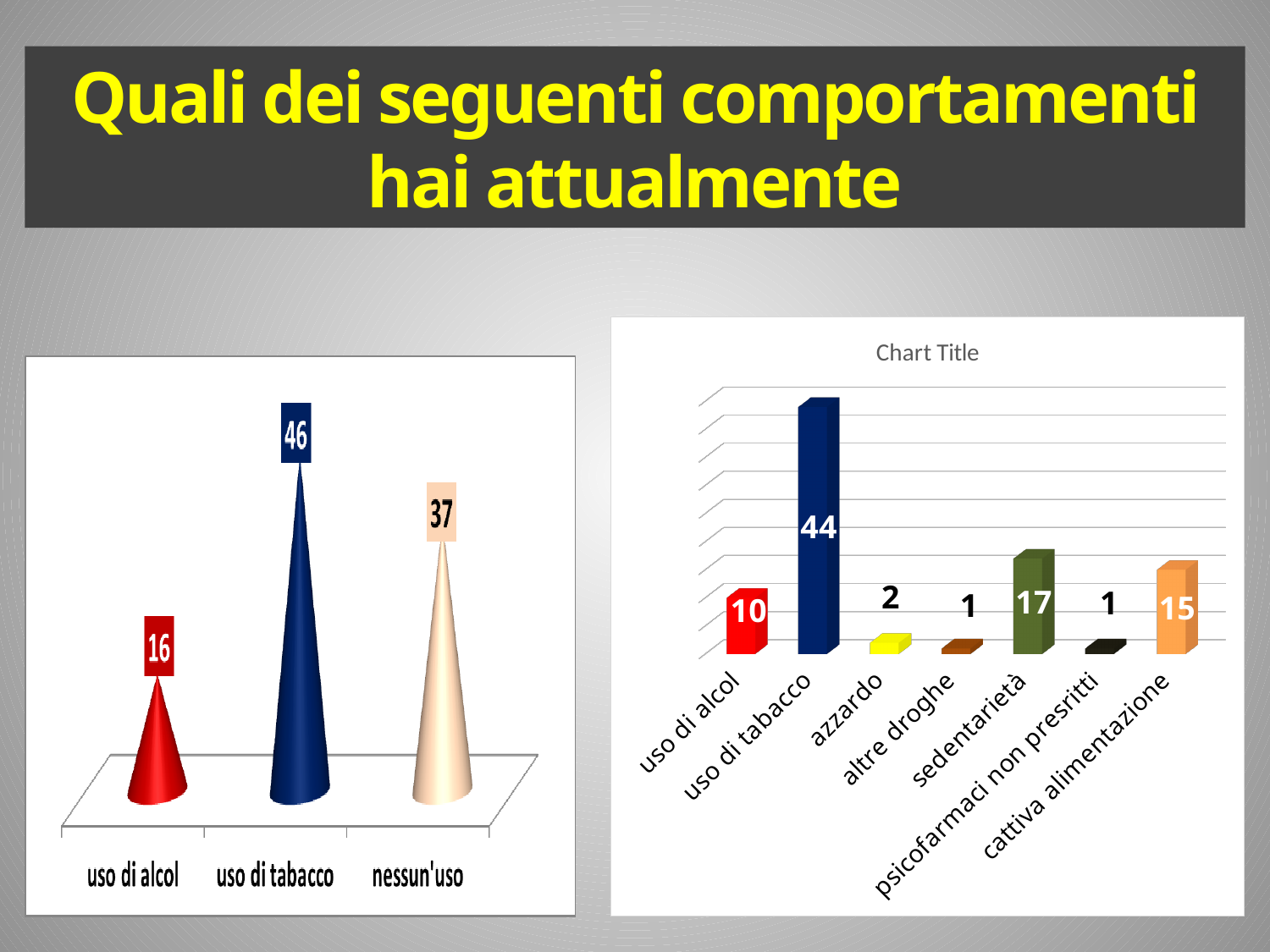
In the chart titled 'Chart Title', what is the value for cattiva alimentazione? 15 In the chart titled 'Chart Title', which is larger, uso di alcol or cattiva alimentazione? cattiva alimentazione In the left chart, what is the value for uso di tabacco? 46 How many categories are shown in the chart titled 'Chart Title'? 7 In the left chart, which category has the lowest value? uso di alcol What kind of chart is the chart titled 'Chart Title'? bar chart In the chart titled 'Chart Title', which category has the highest value? uso di tabacco In the left chart, what is the difference between uso di tabacco and uso di alcol? 30 How many categories are shown in the left chart? 3 In the chart titled 'Chart Title', what is the difference between uso di tabacco and sedentarietà? 27 In the chart titled 'Chart Title', what is the value for sedentarietà? 17 In the left chart, what is the value for nessun'uso? 37